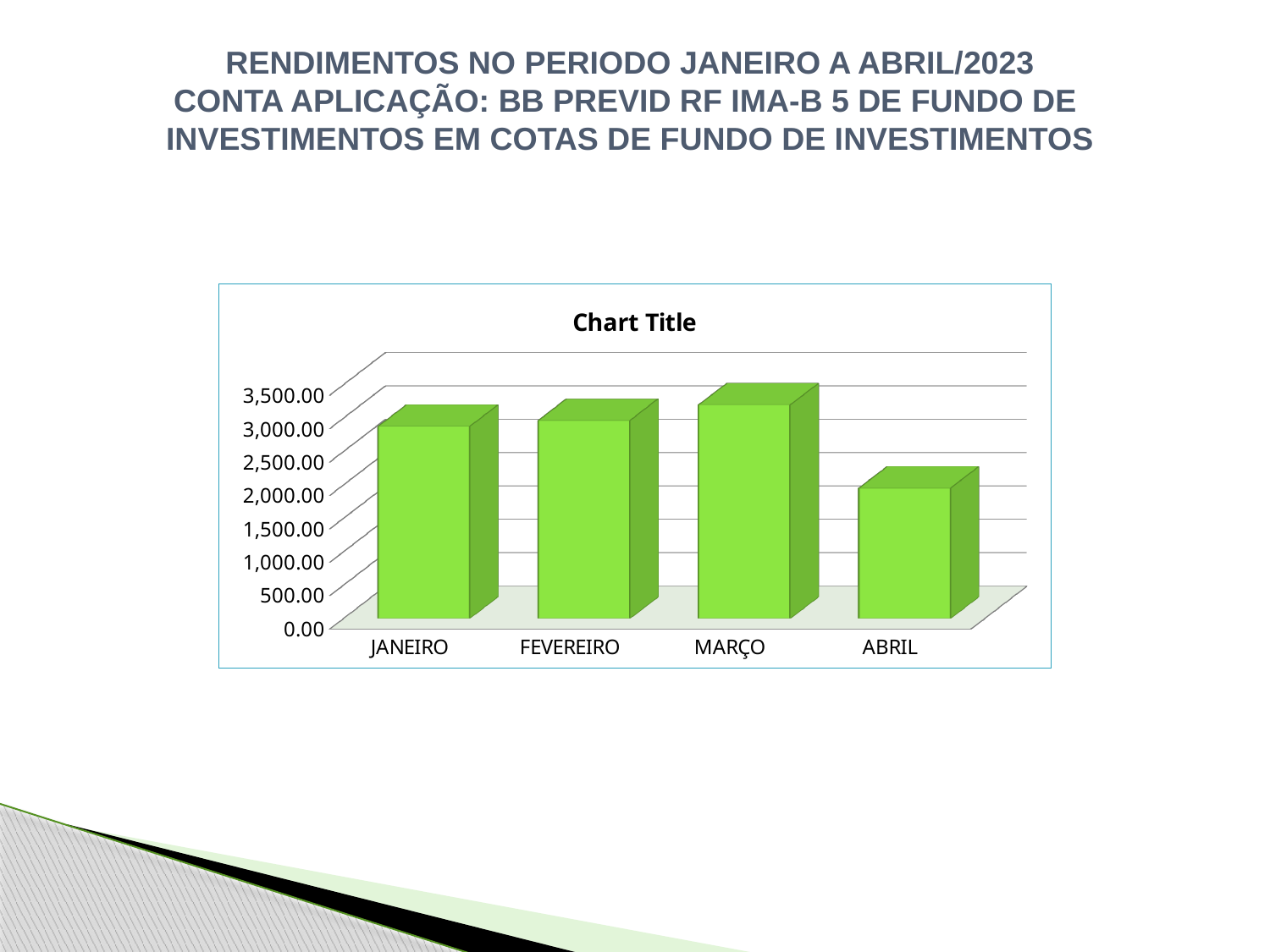
Is the value for ABRIL greater or less than 1,500.00? greater Which month has the highest value in the chart? MARÇO Which month has the lowest value in the chart? ABRIL Does the value rise or fall from MARÇO to ABRIL? fall Is the value for JANEIRO greater or less than 2,500.00? greater What kind of chart is shown on the slide? bar chart What is the title shown inside the chart area? Chart Title Which is larger, the value for MARÇO or the value for ABRIL? MARÇO How many categories are shown on the x axis of the chart? 4 Is the value for MARÇO greater or less than 3,000.00? greater Which is larger, the value for JANEIRO or the value for ABRIL? JANEIRO